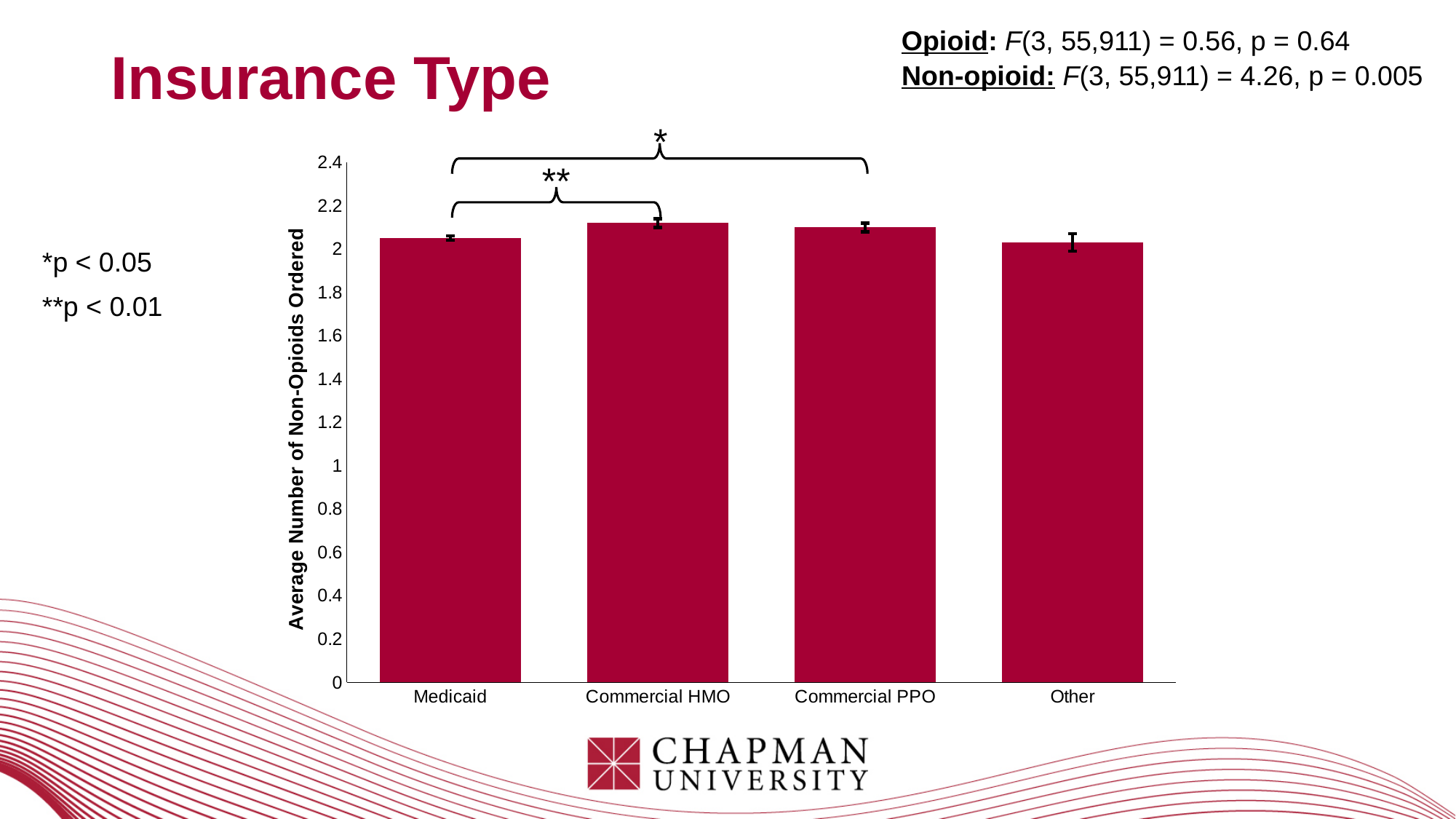
Which two categories are connected by the bracket marked with two asterisks (**)? Medicaid and Commercial HMO Is the value for Medicaid greater or less than 2? greater Which has the larger value, Commercial HMO or Other? Commercial HMO What kind of chart is shown on the slide? bar chart Which has the larger value, Medicaid or Commercial HMO? Commercial HMO What is the highest tick value shown on the y axis? 2.4 Is the value for Other greater or less than 2.2? less What is the label of the last category on the x axis? Other Is the value for Commercial HMO greater or less than 2? greater How many insurance type categories are plotted on the x axis? 4 What is the label of the y axis? Average Number of Non-Opioids Ordered